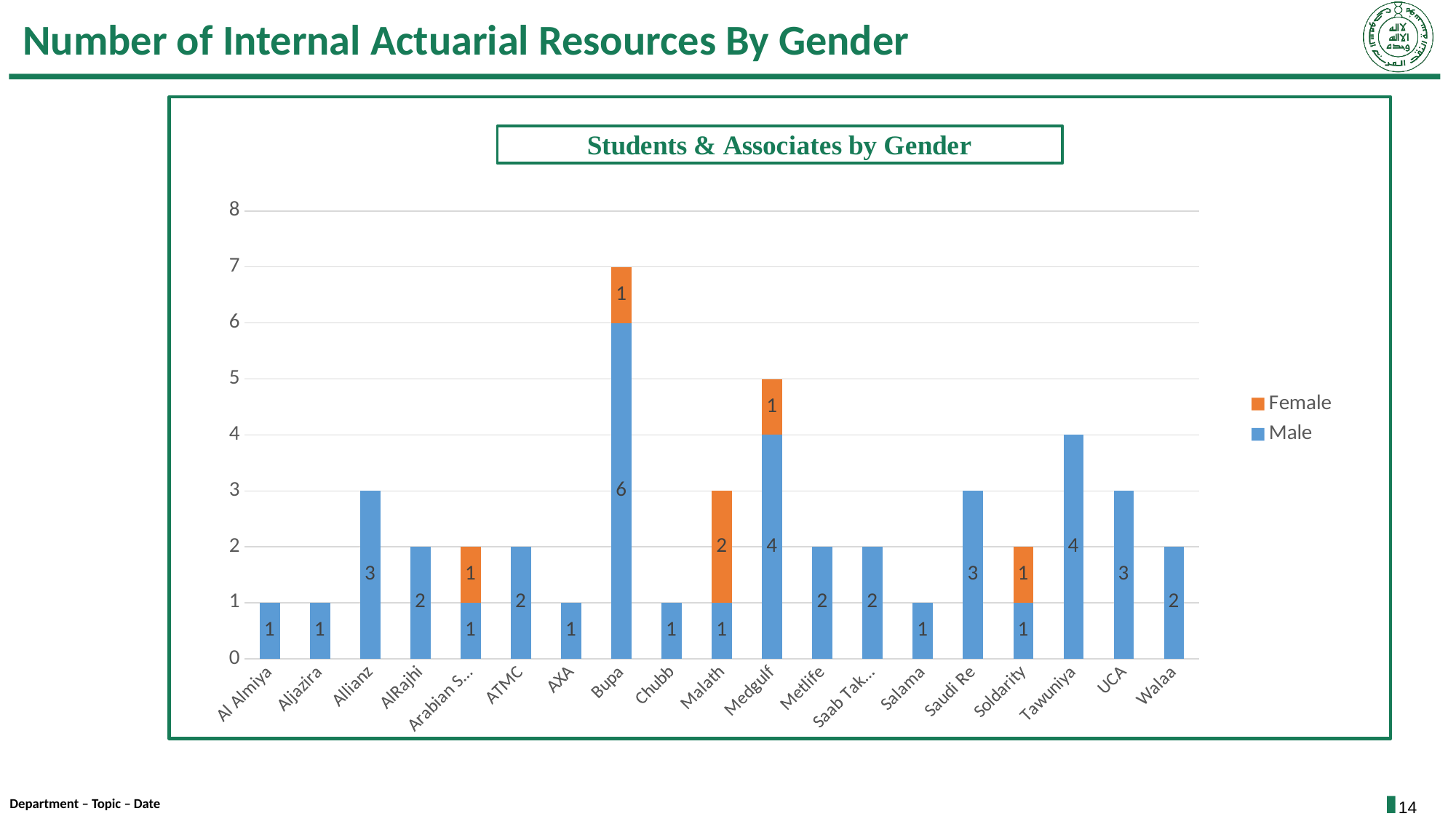
What kind of chart is shown on the slide? Stacked bar chart What is the Male value for Tawuniya? 4 What is the total of the stacked bar for Bupa? 7 Which company has the highest Male value? Bupa What is the total of the stacked bar for Medgulf? 5 How many series does the legend list? 2 How many companies are shown on the x axis? 19 What is the Male value for Bupa? 6 What is the Female value for Malath? 2 Which company has the highest Female value? Malath What is the difference between the Male values for Bupa and Medgulf? 2 Which is larger, the Male value for Allianz or the Male value for AlRajhi? Allianz